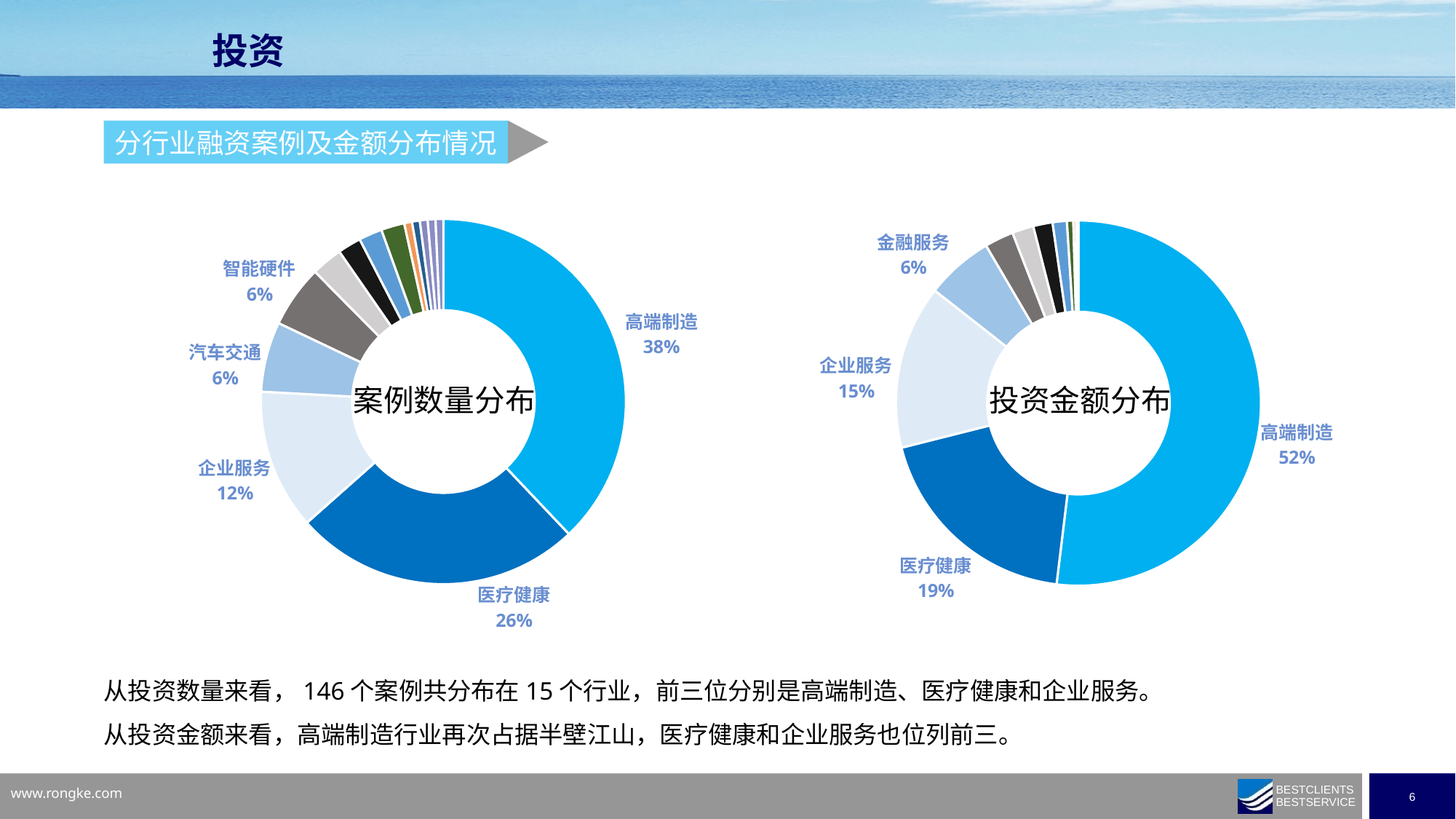
What type of chart is the 投资金额分布 chart? Pie (donut) chart In the 投资金额分布 chart, what share does 金融服务 have? 6% In the 案例数量分布 chart, what is the difference in percentage points between 高端制造 and 医疗健康? 12 What is the title of the chart on the left side of the slide? 案例数量分布 Which chart gives 企业服务 a larger share, 案例数量分布 or 投资金额分布? 投资金额分布 In the 投资金额分布 chart, what share does 医疗健康 have? 19% In the 案例数量分布 chart, what share does 高端制造 have? 38% In the 投资金额分布 chart, which category has the largest share? 高端制造